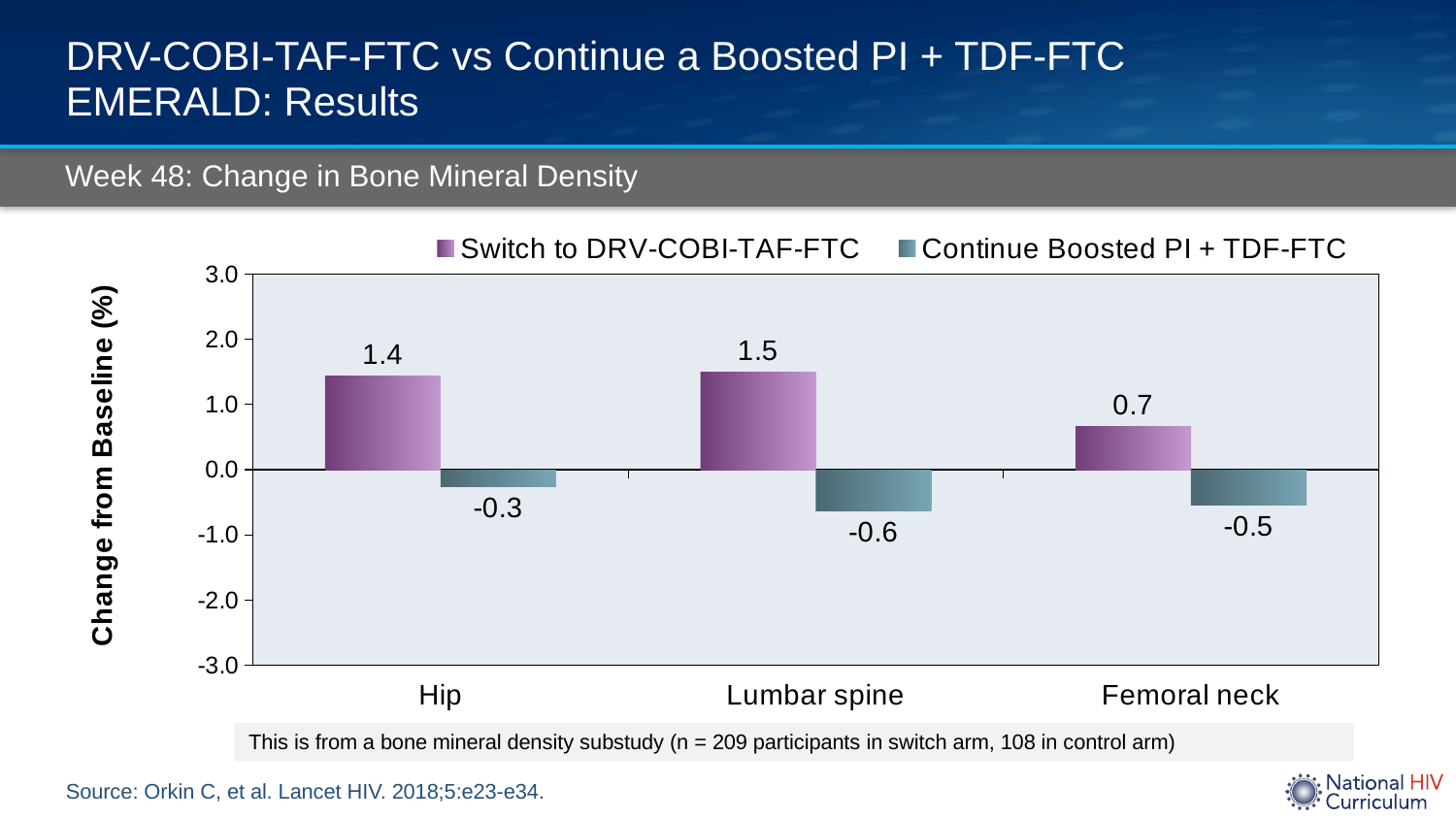
Is the Switch to DRV-COBI-TAF-FTC value for Lumbar spine greater or less than 1.0? greater What is the change from baseline for Hip in the Switch to DRV-COBI-TAF-FTC series? 1.4 How many categories are shown on the x axis? 3 Which category has the lowest value in the Continue Boosted PI + TDF-FTC series? Lumbar spine What kind of chart is shown on the slide? Bar chart How many series does the legend list? 2 What is the change from baseline for Lumbar spine in the Continue Boosted PI + TDF-FTC series? -0.6 Which is larger: the Switch to DRV-COBI-TAF-FTC value for Hip or for Femoral neck? Hip What is the label of the y axis? Change from Baseline (%) What is the change from baseline for Femoral neck in the Switch to DRV-COBI-TAF-FTC series? 0.7 What is the difference between the Switch to DRV-COBI-TAF-FTC and Continue Boosted PI + TDF-FTC values for Hip? 1.7 Which category has the highest value in the Switch to DRV-COBI-TAF-FTC series? Lumbar spine